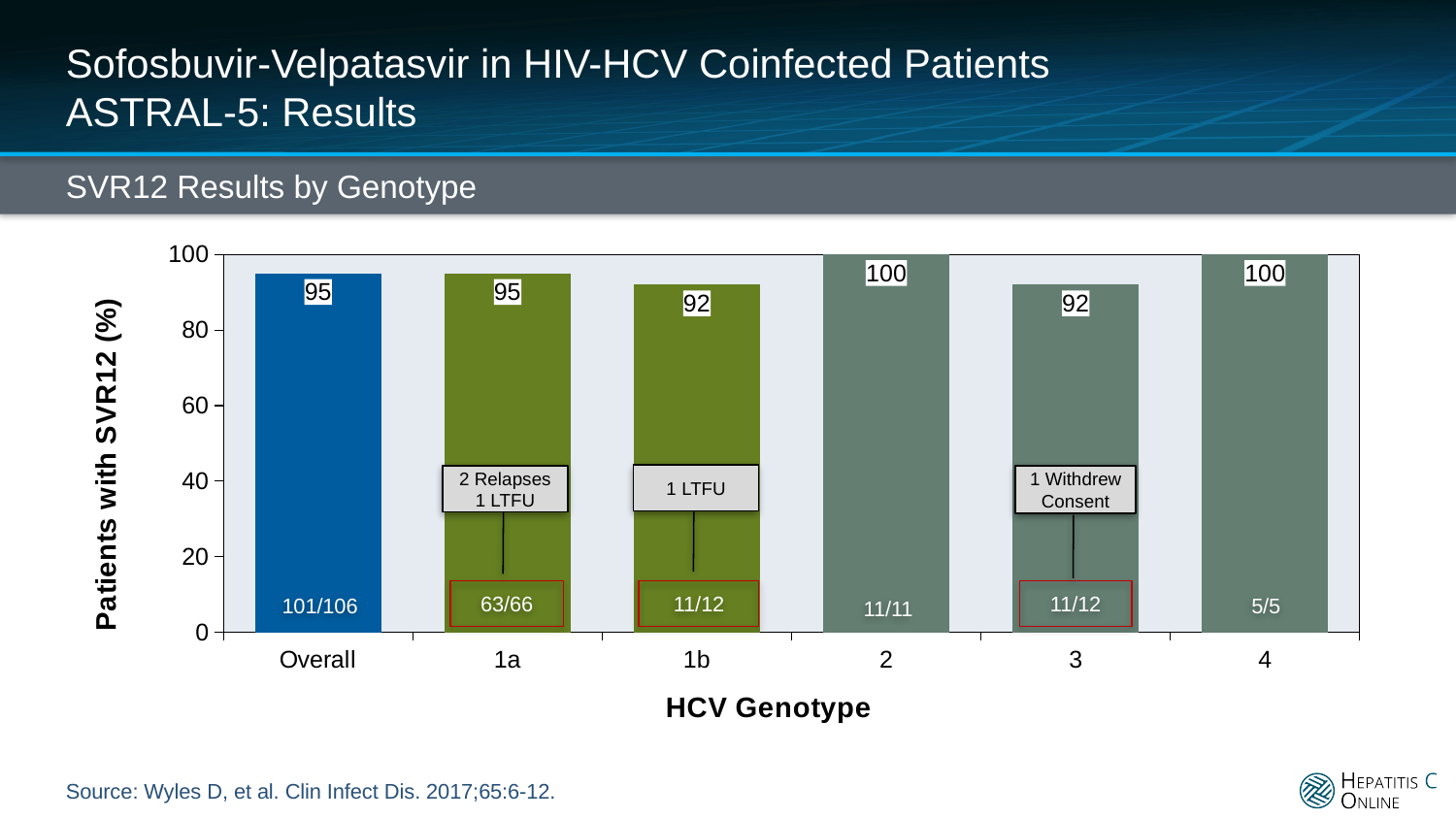
What kind of chart is shown on the slide? Bar chart How many categories are shown on the x axis? 6 What is the difference in SVR12 rate between genotype 2 and genotype 1b? 8 Which genotypes have the highest SVR12 rate? 2 and 4 What is the SVR12 rate for genotype 1b? 92 What is the SVR12 rate for the Overall group? 95 What is the label on the y axis? Patients with SVR12 (%) How many patients achieved SVR12 in the Overall group, as shown by the fraction label? 101/106 What is the SVR12 rate for genotype 3? 92 Is the SVR12 rate for genotype 1a greater or less than 80? greater What annotation is shown on the genotype 3 bar? 1 Withdrew Consent What fraction label is shown for genotype 1a? 63/66